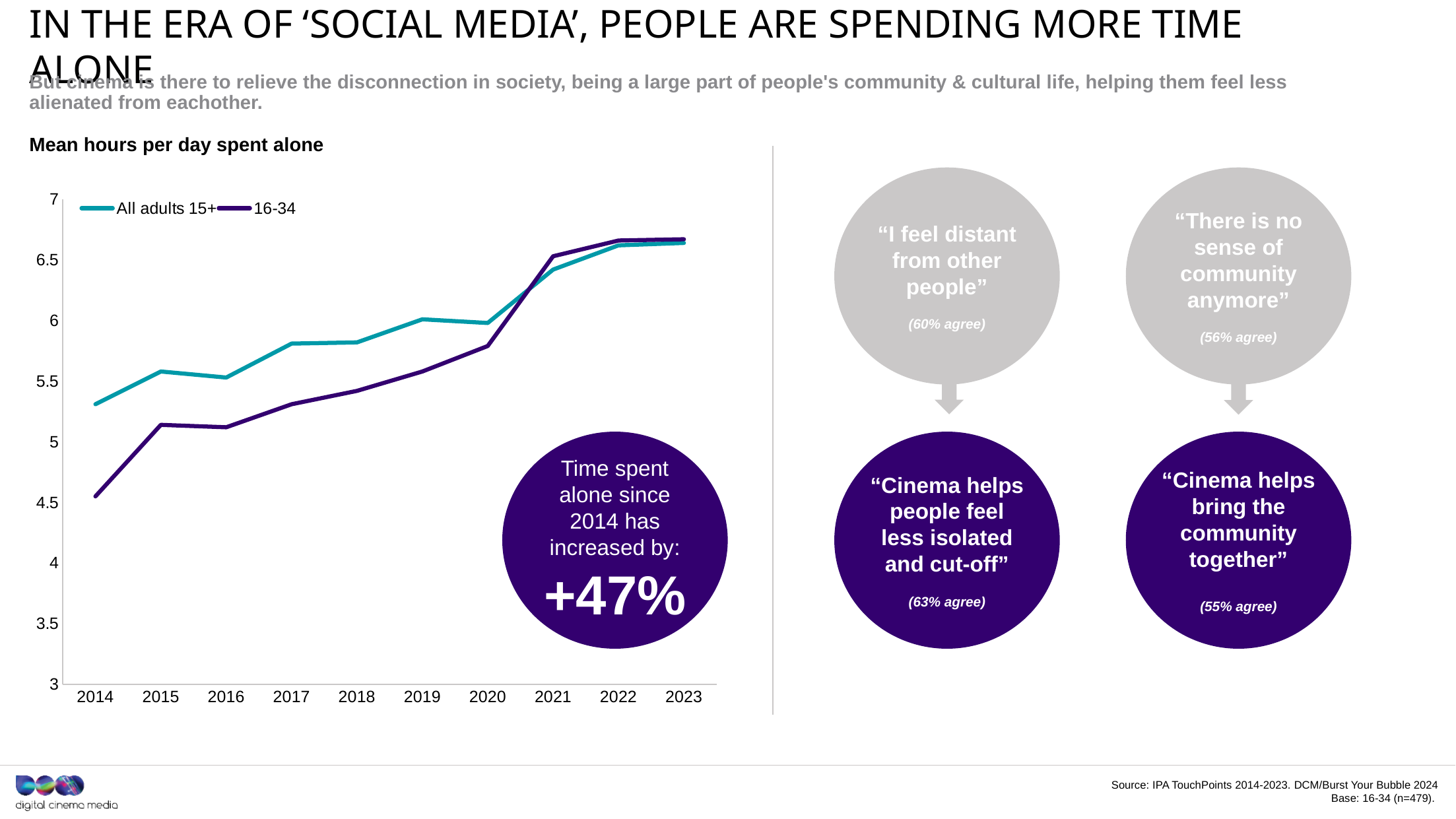
Is the value for the 16-34 series in 2014 greater or less than 5? less Is the value for the 16-34 series in 2017 greater or less than 5.5? less How many series does the legend of the 'Mean hours per day spent alone' chart list? 2 How many years are plotted along the x axis of the 'Mean hours per day spent alone' chart? 10 Is the value for the All adults 15+ series in 2014 greater or less than 5? greater Do the values for the 16-34 series generally rise or fall from 2014 to 2023? Rise In 2014, which series has the higher value: All adults 15+ or 16-34? All adults 15+ In which year is the value for the 16-34 series lowest? 2014 What kind of chart is shown under 'Mean hours per day spent alone'? Line chart In which year is the value for the All adults 15+ series lowest? 2014 What are the two series named in the legend of the 'Mean hours per day spent alone' chart? All adults 15+ and 16-34